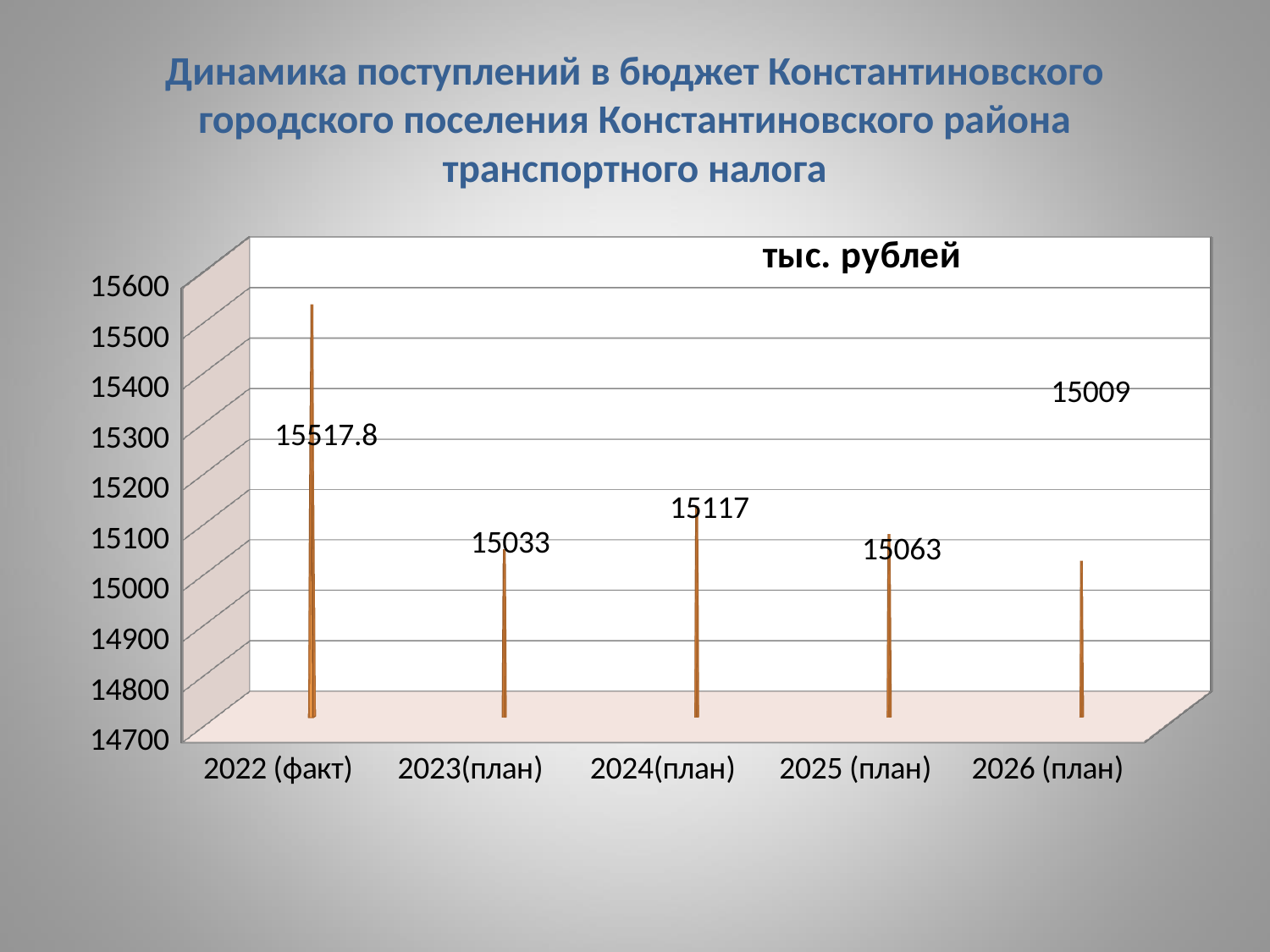
How many categories are shown on the x axis? 5 Which category has the highest value? 2022 (факт) What unit label is shown inside the chart area? тыс. рублей Is the value for 2022 (факт) greater or less than 15400? greater Which category has the lowest value? 2026 (план) What is the value for 2026 (план)? 15009 Which is larger, the value for 2025 (план) or the value for 2026 (план)? 2025 (план) What kind of chart is shown on the slide? bar chart What is the value for 2024(план)? 15117 What is the value for 2025 (план)? 15063 What is the difference between the values for 2024(план) and 2023(план)? 84 What is the value for 2022 (факт)? 15517.8